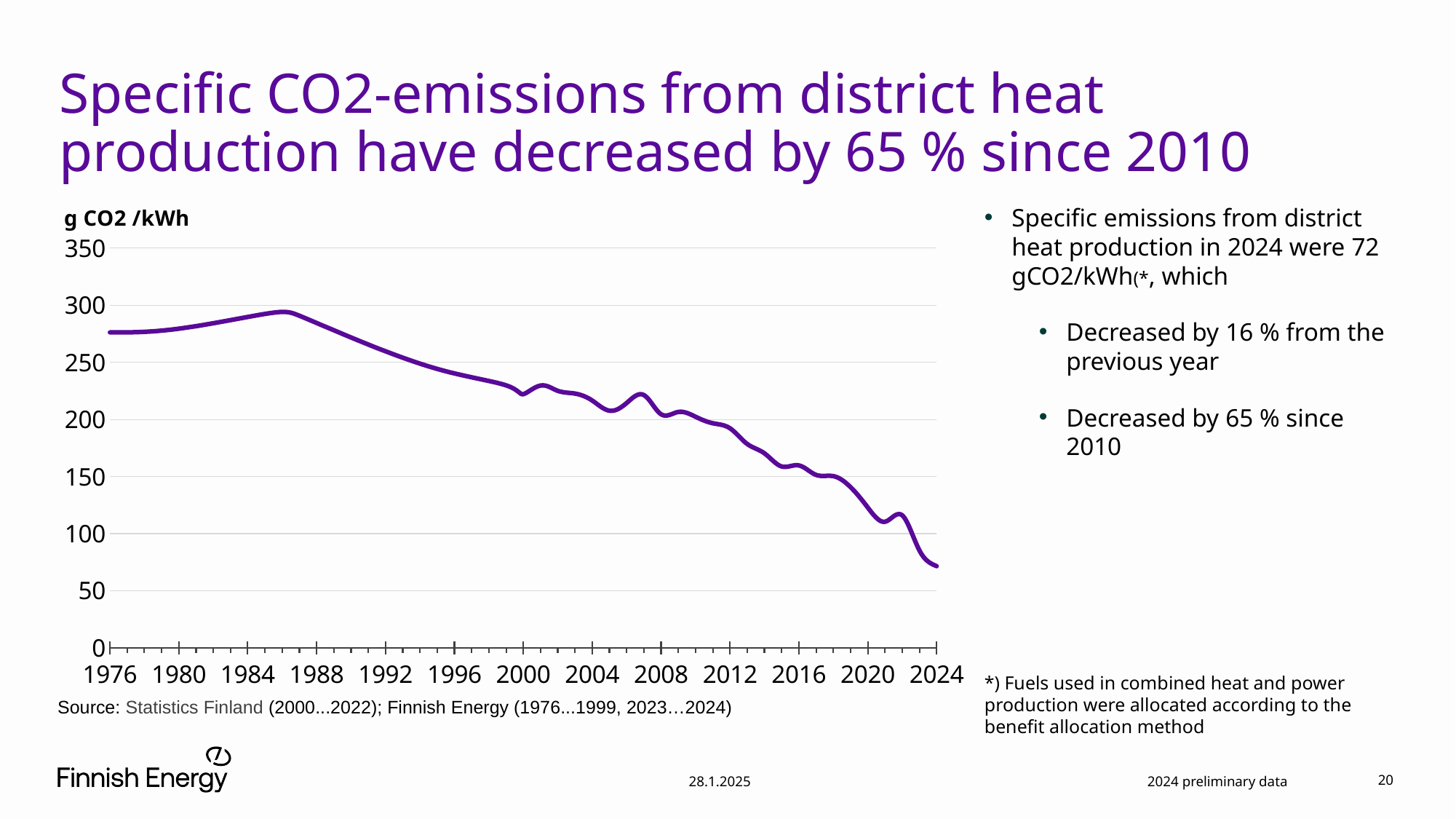
What were the specific emissions from district heat production in 2024, according to the slide? 72 gCO2/kWh Do the values rise or fall along the x axis from 1988 to 2024? fall Is the value for 2024 greater or less than 100? less What kind of chart is shown on the slide? line chart What unit is shown on the y axis of the chart? g CO2 /kWh In which year does the line reach its lowest value? 2024 Is the value for 2016 greater or less than 200? less Which year has the larger value, 1976 or 2024? 1976 Is the value for 1976 greater or less than 250? greater How many data series are plotted on the chart? 1